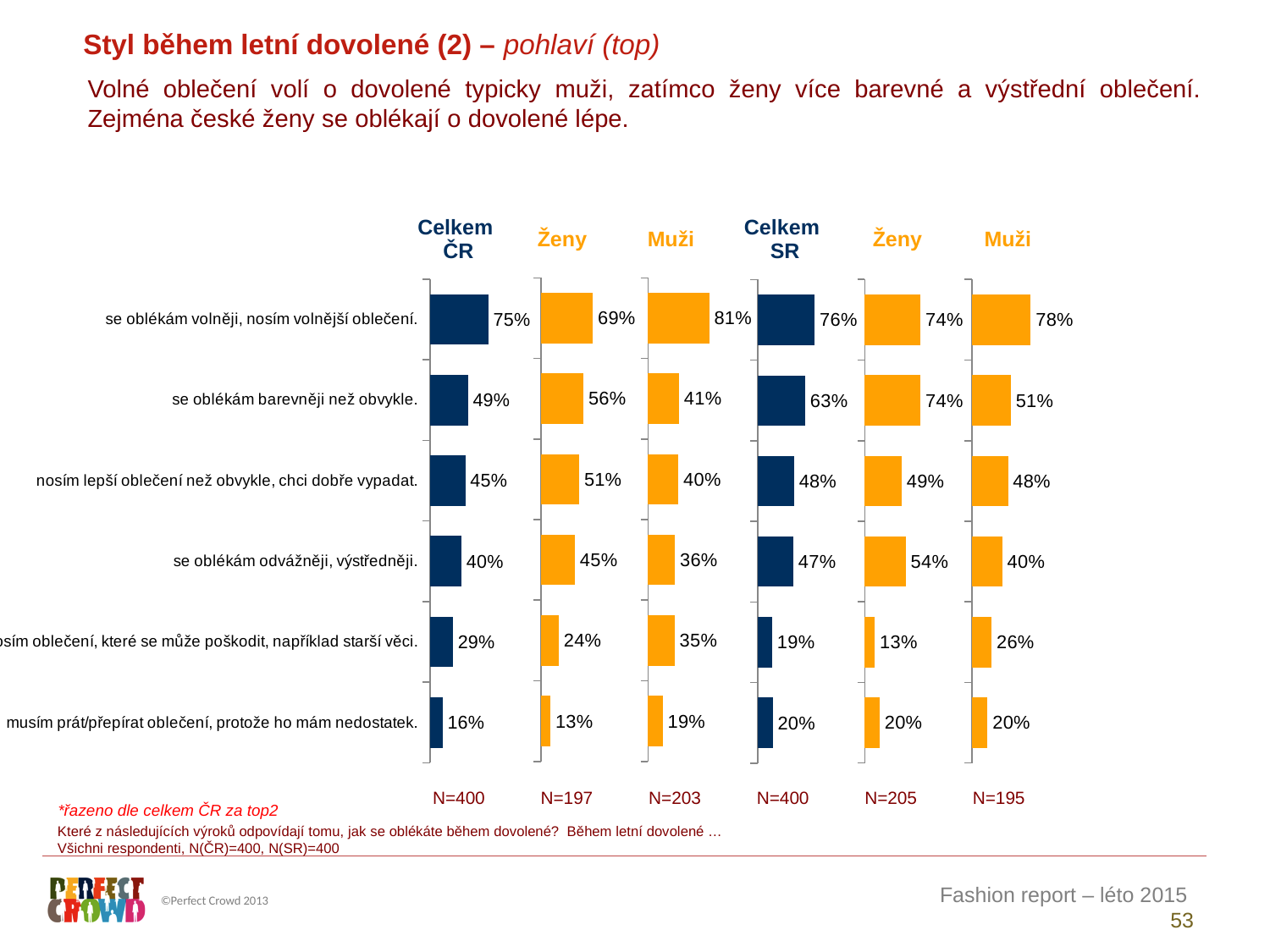
What is the difference between the Muži (ČR) and Ženy (ČR) values for "se oblékám volněji, nosím volnější oblečení"? 12% How many categories are shown in each chart? 6 What is the difference between the Celkem SR and Celkem ČR values for "se oblékám barevněji než obvykle"? 14% In the Celkem SR chart, what is the value for "se oblékám barevněji než obvykle"? 63% In the Muži chart for ČR (third chart from the left), what is the value for "se oblékám odvážněji, výstředněji"? 36% In the Celkem ČR chart, which category has the lowest value? musím prát/přepírat oblečení, protože ho mám nedostatek. In the Celkem ČR chart, what is the value for "se oblékám volněji, nosím volnější oblečení"? 75% In the Celkem SR chart, which category has the highest value? se oblékám volněji, nosím volnější oblečení. What is the sample size (N) shown under the Muži chart for SR (rightmost chart)? N=195 What type of chart is used on this slide? Bar chart In the Ženy chart for SR (fifth chart from the left), what is the value for "se oblékám barevněji než obvykle"? 74% For "se oblékám barevněji než obvykle", which is larger: the Ženy (ČR) value or the Muži (ČR) value? Ženy (ČR), 56%